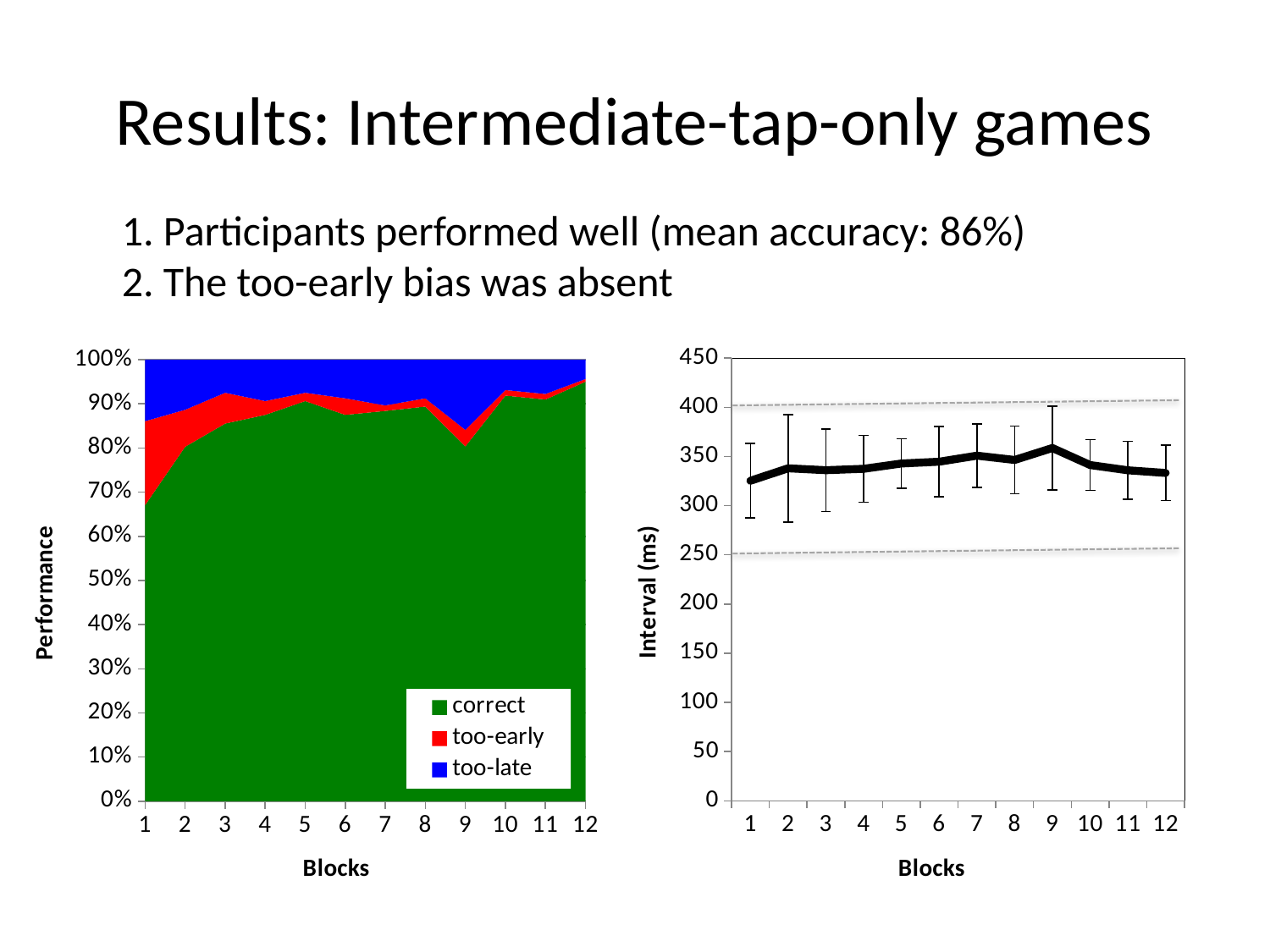
In the right chart (Interval (ms)), is the value at block 1 greater or less than 300? greater In the left chart (Performance), how many series does the legend list? 3 In the right chart (Interval (ms)), is the value at block 9 greater or less than 400? less In the left chart (Performance), is the 'correct' share at block 1 greater or less than 80%? less In the left chart (Performance), how many blocks are shown on the x axis? 12 What kind of chart is the left chart titled with the y-axis 'Performance'? stacked area chart In the left chart (Performance), what are the three legend entries? correct, too-early, too-late What kind of chart is the right chart with the y-axis 'Interval (ms)'? line chart In the right chart (Interval (ms)), how many blocks are plotted along the x axis? 12 In the left chart (Performance), which block has the lowest 'correct' share? 1 In the left chart (Performance), which block has the largest 'too-early' share? 1